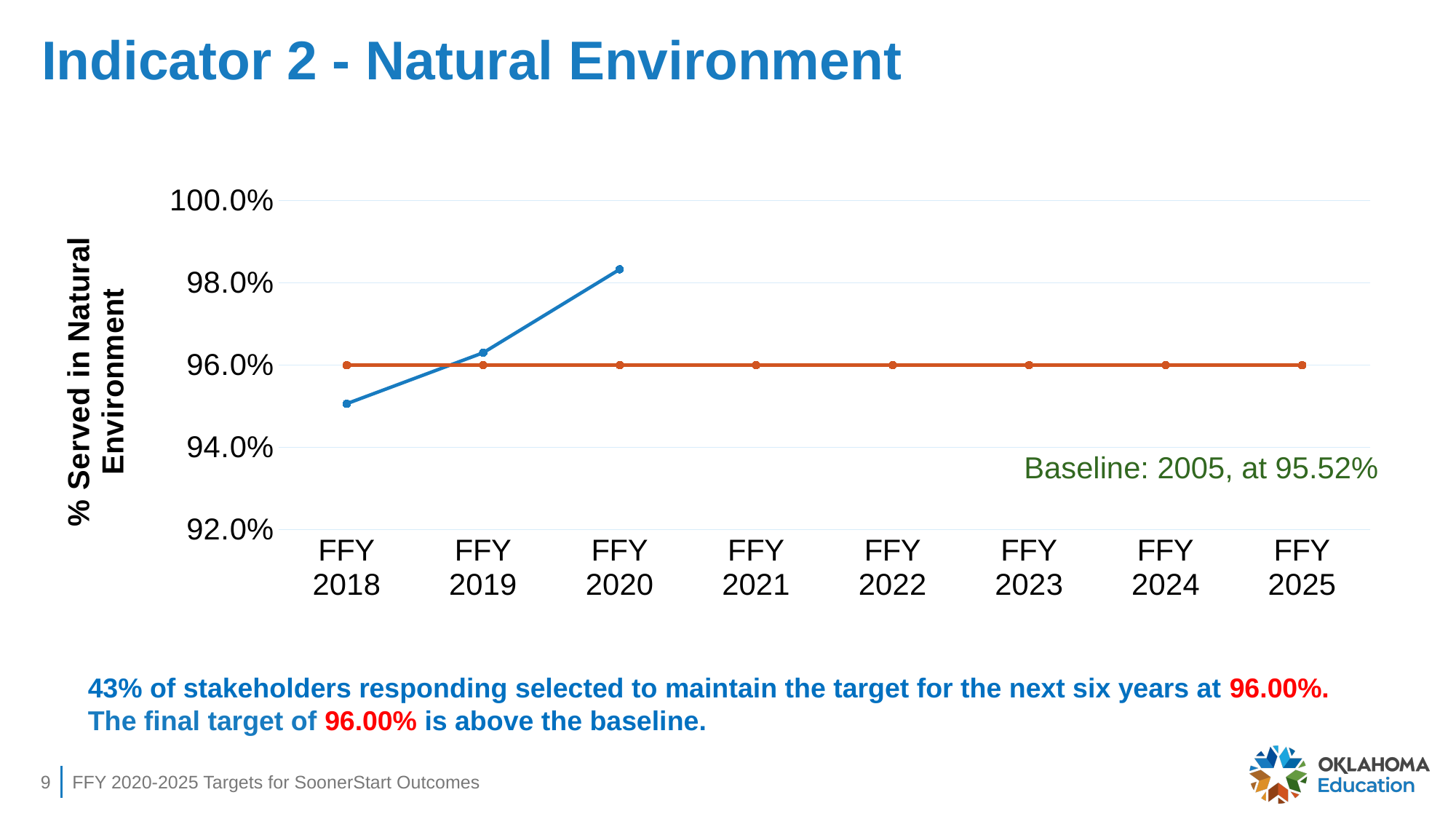
Does the blue line rise or fall from FFY 2018 to FFY 2020? rise What baseline value is noted on the chart? Baseline: 2005, at 95.52% How many lines (series) are plotted on the chart? 2 What kind of chart is shown on the slide? line chart How many FFY categories are shown on the x axis? 8 Is the blue line's value for FFY 2018 greater or less than 96.0%? less Is the blue line's value for FFY 2020 greater or less than 96.0%? greater Which is larger on the blue line: the value for FFY 2018 or FFY 2020? FFY 2020 In which FFY does the blue line have its lowest value? FFY 2018 In which FFY does the blue line reach its highest value? FFY 2020 What is the title of the y axis? % Served in Natural Environment At what value does the flat orange target line sit? 96.0%